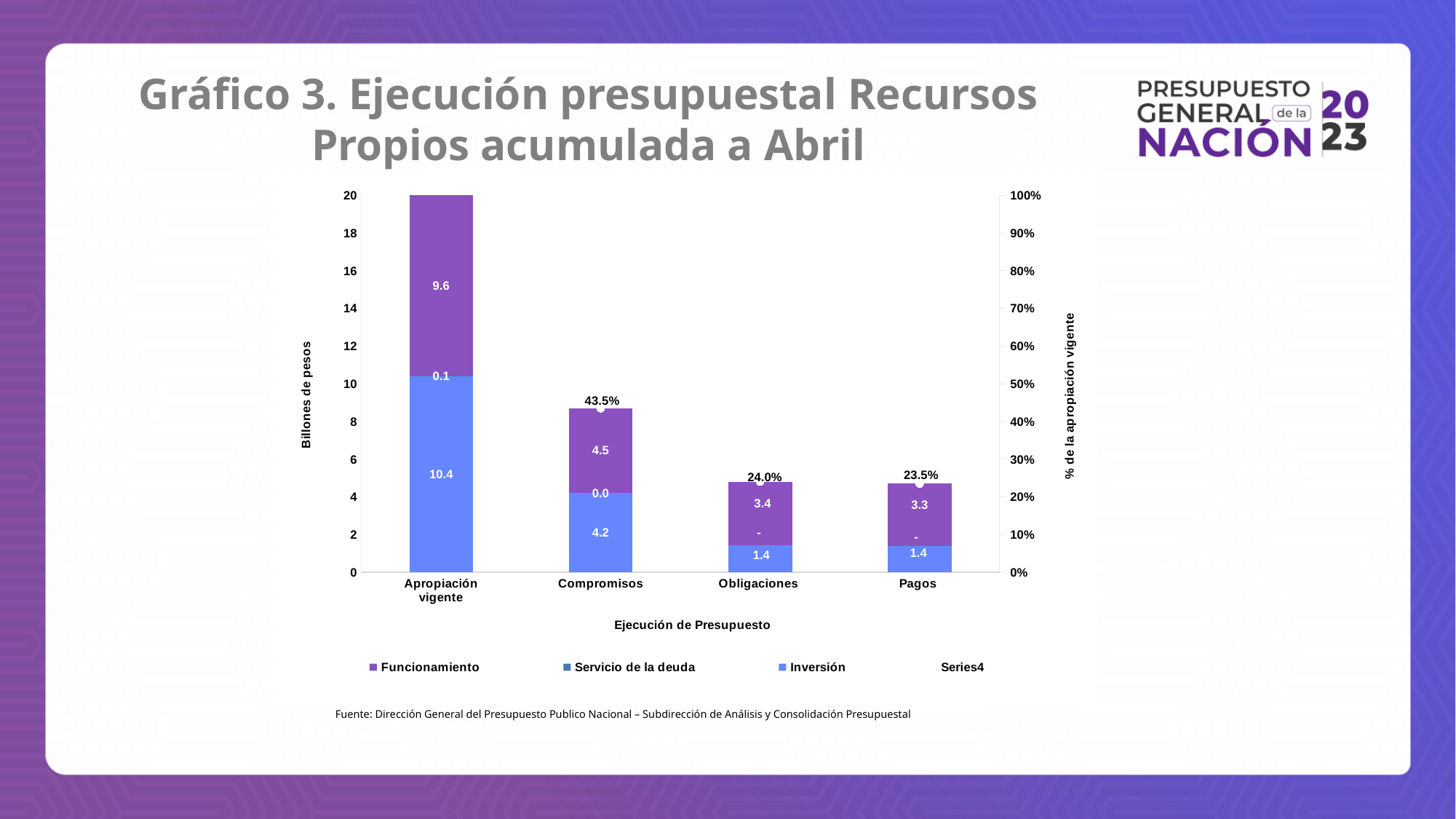
What is the Inversión value for Apropiación vigente? 10.4 Which category has the highest Funcionamiento value? Apropiación vigente How many series does the legend list? 4 What kind of chart is shown? Stacked bar chart Which category has the lowest percentage label? Pagos In the Compromisos bar, which is larger: Inversión or Funcionamiento? Funcionamiento What is the total of the Compromisos stacked bar? 8.7 What is the Funcionamiento value for Pagos? 3.3 What percentage of the apropiación vigente is shown above the Obligaciones bar? 24.0% What is the Funcionamiento value for Compromisos? 4.5 How many categories are shown on the x axis? 4 What is the difference between the Funcionamiento value for Compromisos and for Obligaciones? 1.1